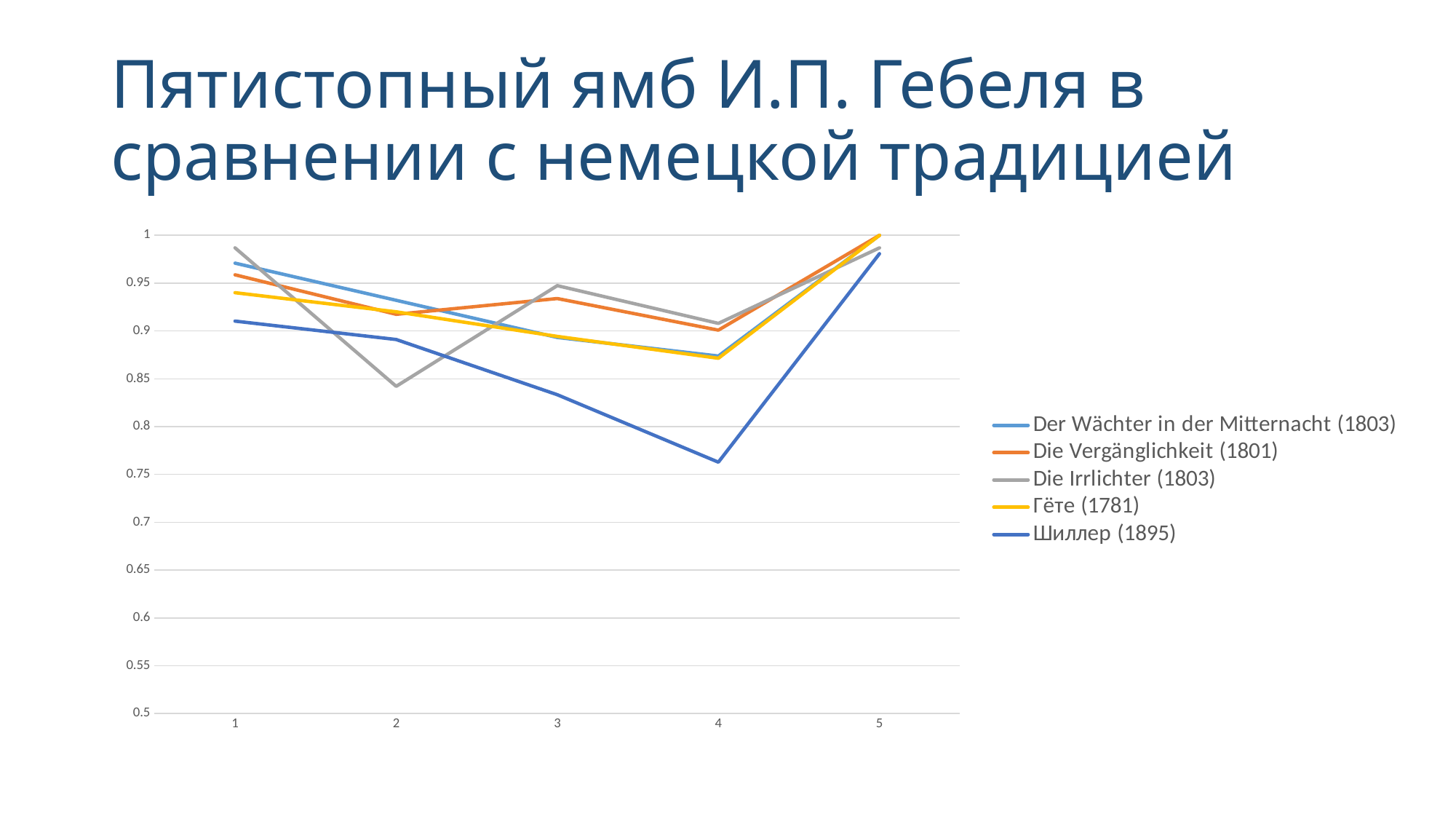
Is the value for Der Wächter in der Mitternacht (1803) at point 1 greater or less than 0.95? greater Which series has the lowest value at point 4? Шиллер (1895) At point 2, which is larger: Die Irrlichter (1803) or Шиллер (1895)? Шиллер (1895) What is the lowest value shown on the y axis? 0.5 What kind of chart is shown on the slide? line chart Is the value for Шиллер (1895) at point 4 greater or less than 0.8? less How many points are there along the x axis? 5 At point 1, which is larger: Die Irrlichter (1803) or Шиллер (1895)? Die Irrlichter (1803) How many series does the legend list? 5 Is the value for Die Irrlichter (1803) at point 2 greater or less than 0.9? less Does the Шиллер (1895) line rise or fall from point 1 to point 4? fall Which series is drawn in yellow? Гёте (1781)